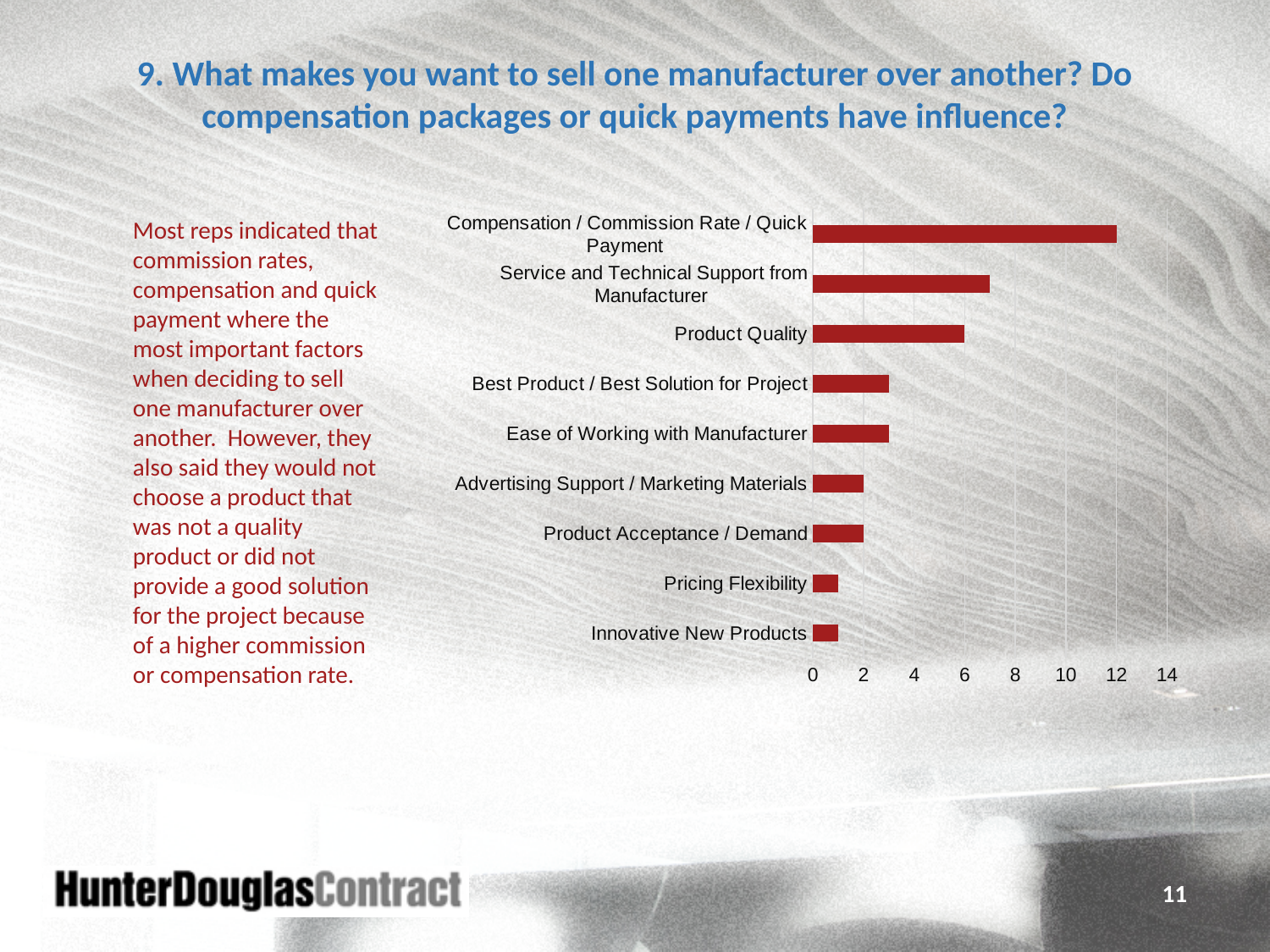
What colour are the bars in the chart? red Which category has the highest value in the chart? Compensation / Commission Rate / Quick Payment Which is larger, the value for Compensation / Commission Rate / Quick Payment or the value for Service and Technical Support from Manufacturer? Compensation / Commission Rate / Quick Payment Is the value for Service and Technical Support from Manufacturer greater or less than 6? greater What is the highest value shown on the chart's horizontal axis? 14 Is the value for Pricing Flexibility greater or less than 2? less Is the value for Best Product / Best Solution for Project greater or less than 2? greater How many categories are plotted in the chart? 9 What kind of chart is shown on the slide? bar chart Which is larger, the value for Best Product / Best Solution for Project or the value for Advertising Support / Marketing Materials? Best Product / Best Solution for Project